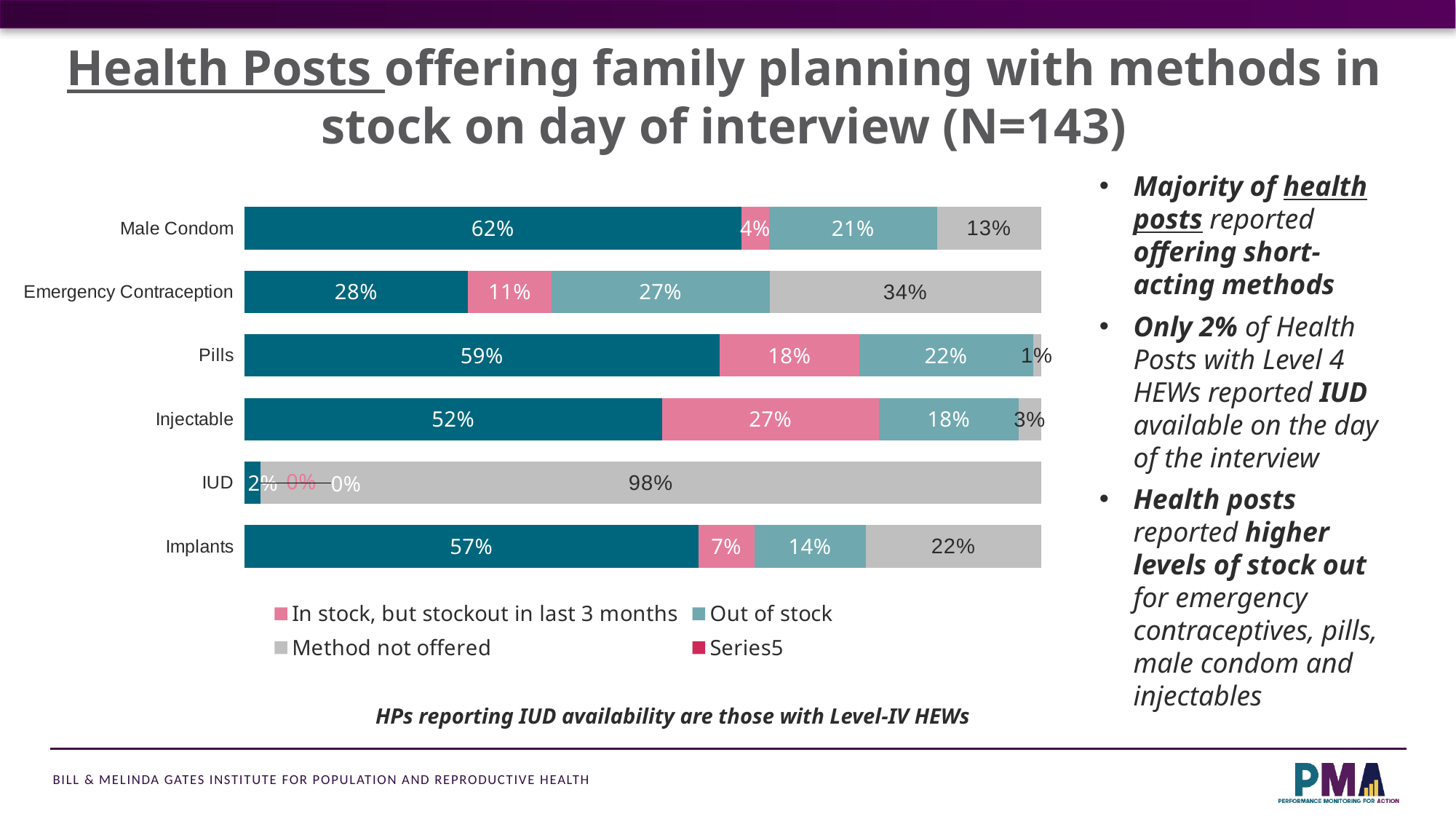
Which method has the highest "Method not offered" value? IUD Which method has the lowest "Method not offered" value? Pills What is the total of the Male Condom bar's labelled segments? 100% How many methods (categories) are shown in the chart? 6 What is the difference between the "Method not offered" values for Emergency Contraception and Implants? 12 percentage points What is the "In stock, but stockout in last 3 months" value for Male Condom? 4% What is the "Method not offered" value for IUD? 98% What percentage of health posts reported Emergency Contraception as "Out of stock"? 27% How many series does the legend list? 4 What is the "In stock, but stockout in last 3 months" value for Injectable? 27% Which has a larger "Out of stock" value, Pills or Implants? Pills What kind of chart is shown on the slide? Stacked bar chart